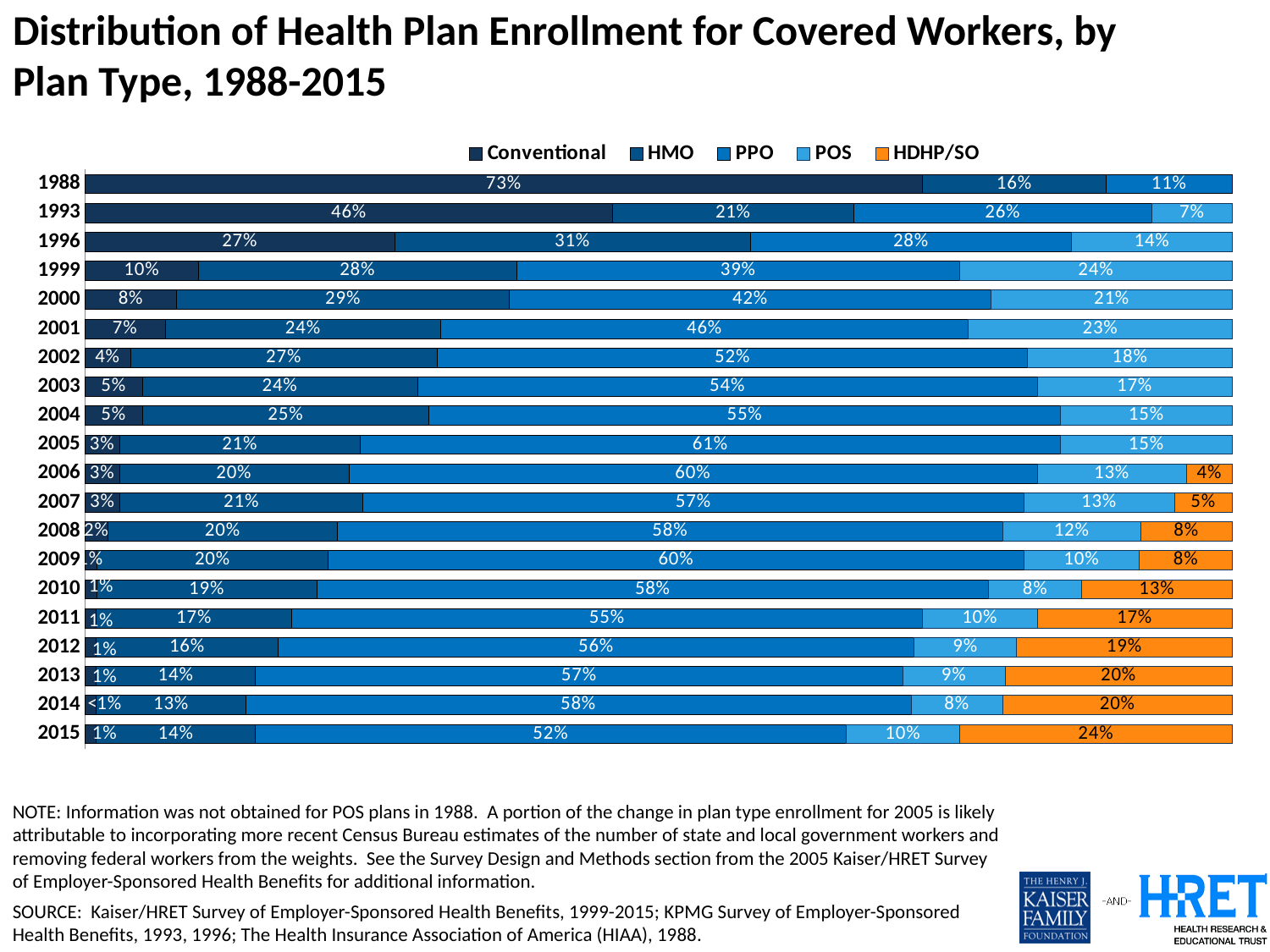
Does the HDHP/SO share rise or fall from 2006 to 2015? Rise What kind of chart is shown on the slide? Stacked bar chart What share of covered workers were in HDHP/SO plans in 2015? 24% What was the HMO enrollment share in 2000? 29% How many years are shown on the chart? 20 In which year was the Conventional plan share the highest? 1988 In which year was the PPO share the highest? 2005 What was the PPO enrollment share in 2005? 61% Which was larger in 2011: the HMO share or the HDHP/SO share? They are equal (17%) What is the difference between the PPO share in 2014 and the PPO share in 2015? 6% What percentage of covered workers were enrolled in Conventional plans in 1988? 73% How many plan types does the legend list? 5